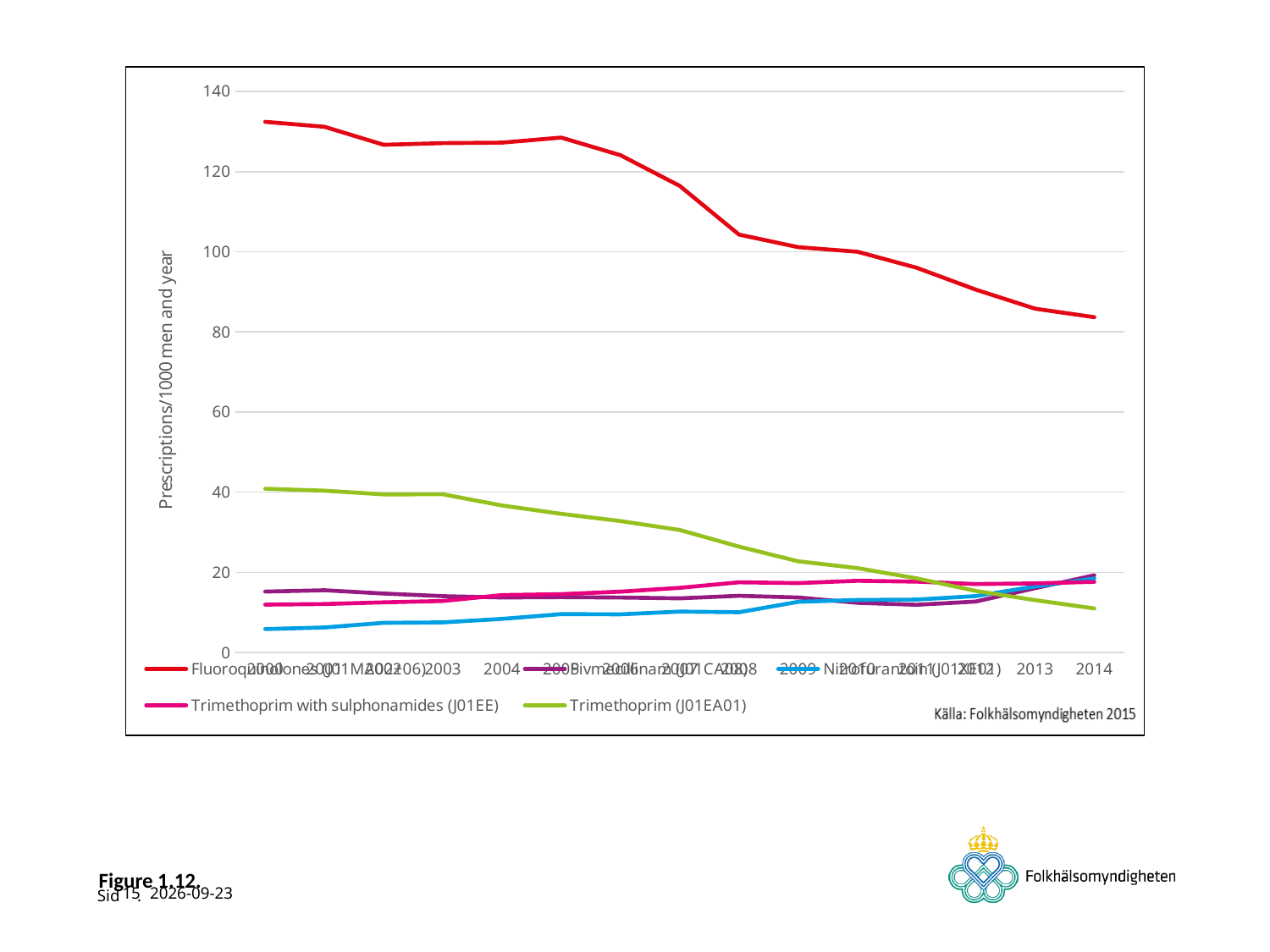
What is the label of the y axis? Prescriptions/1000 men and year How many series does the legend list? 5 How many years are plotted along the x axis? 15 Is the value of the red (top) line in 2000 greater or less than 120? greater Is the value of the Trimethoprim (J01EA01) line in 2014 greater or less than 20? less What source is cited in the bottom right corner of the chart? Källa: Folkhälsomyndigheten 2015 Does the Trimethoprim (J01EA01) line rise or fall from 2000 to 2014? fall Is the value of the red (top) line in 2014 greater or less than 100? less Does the red (top) line rise or fall from 2000 to 2014? fall What kind of chart is shown on the slide? line chart In 2008, which is larger: the red line or the Trimethoprim (J01EA01) line? the red line Which series has the highest values across all years? the red line (Fluoroquinolones)